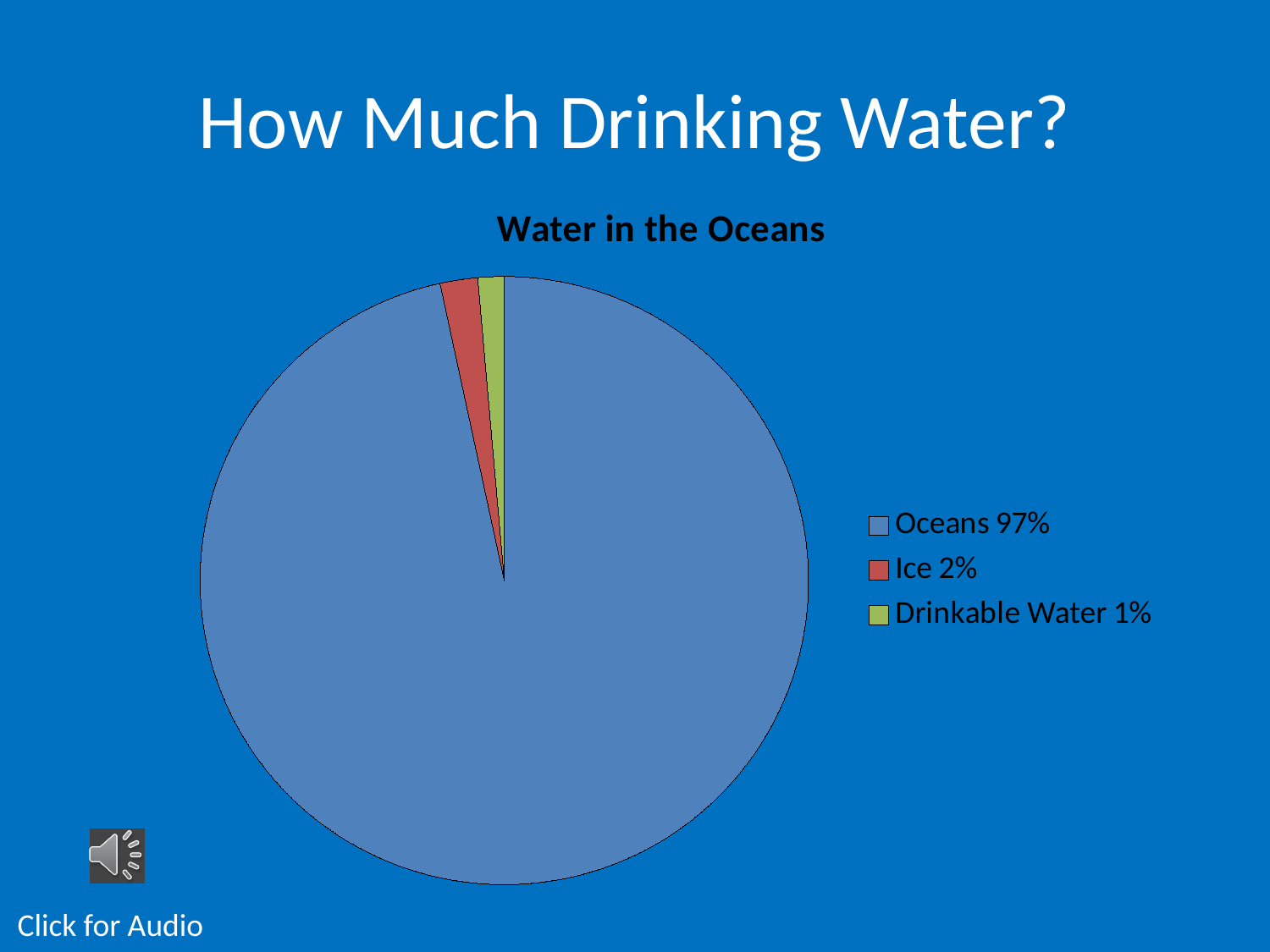
What kind of chart is shown on the slide? pie chart What is the title of the chart? Water in the Oceans What percentage does the legend give for Oceans? 97% What percentage does the legend give for Drinkable Water? 1% How many slices does the pie chart have? 3 What colour is the Ice slice? red How many entries does the legend list? 3 What is the difference in percentage points between Oceans and Ice? 95 Which category has the smallest slice of the pie? Drinkable Water Which category has the largest slice of the pie? Oceans What percentage does the legend give for Ice? 2% Which is larger, the Ice slice or the Drinkable Water slice? Ice